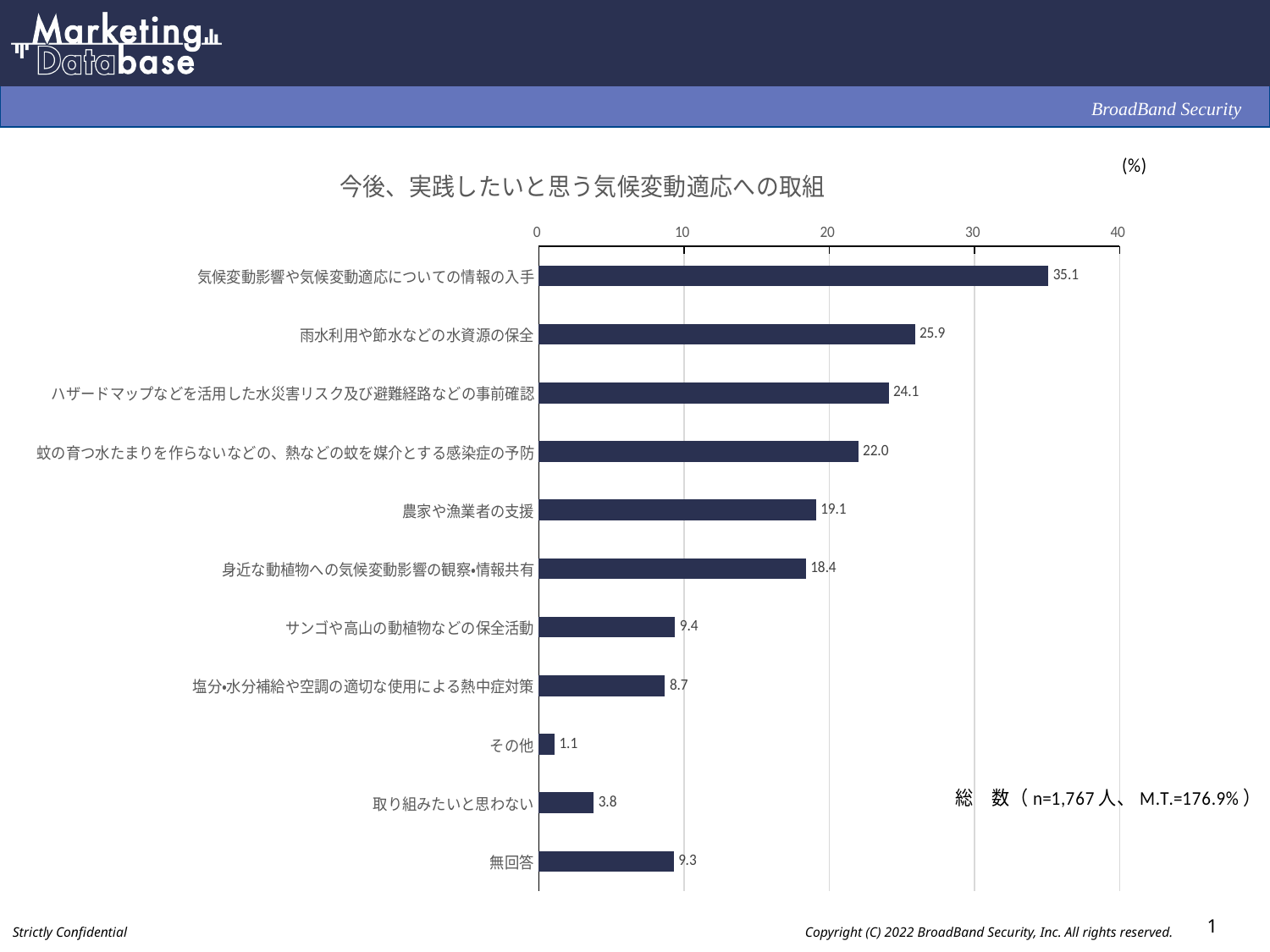
Which category has the lowest value? その他 How many categories are shown in the chart? 11 Which is larger, the value for ハザードマップなどを活用した水災害リスク及び避難経路などの事前確認 or the value for 蚊の育つ水たまりを作らないなどの、熱などの蚊を媒介とする感染症の予防? ハザードマップなどを活用した水災害リスク及び避難経路などの事前確認 What is the value for 気候変動影響や気候変動適応についての情報の入手? 35.1 What is the title of the chart? 今後、実践したいと思う気候変動適応への取組 Which category has the highest value? 気候変動影響や気候変動適応についての情報の入手 What is the value for 雨水利用や節水などの水資源の保全? 25.9 What type of chart is shown on the slide? bar chart What is the value for 無回答? 9.3 Is the value for 身近な動植物への気候変動影響の観察•情報共有 greater or less than 20? less What is the value for 農家や漁業者の支援? 19.1 What is the difference between the values for 気候変動影響や気候変動適応についての情報の入手 and 雨水利用や節水などの水資源の保全? 9.2